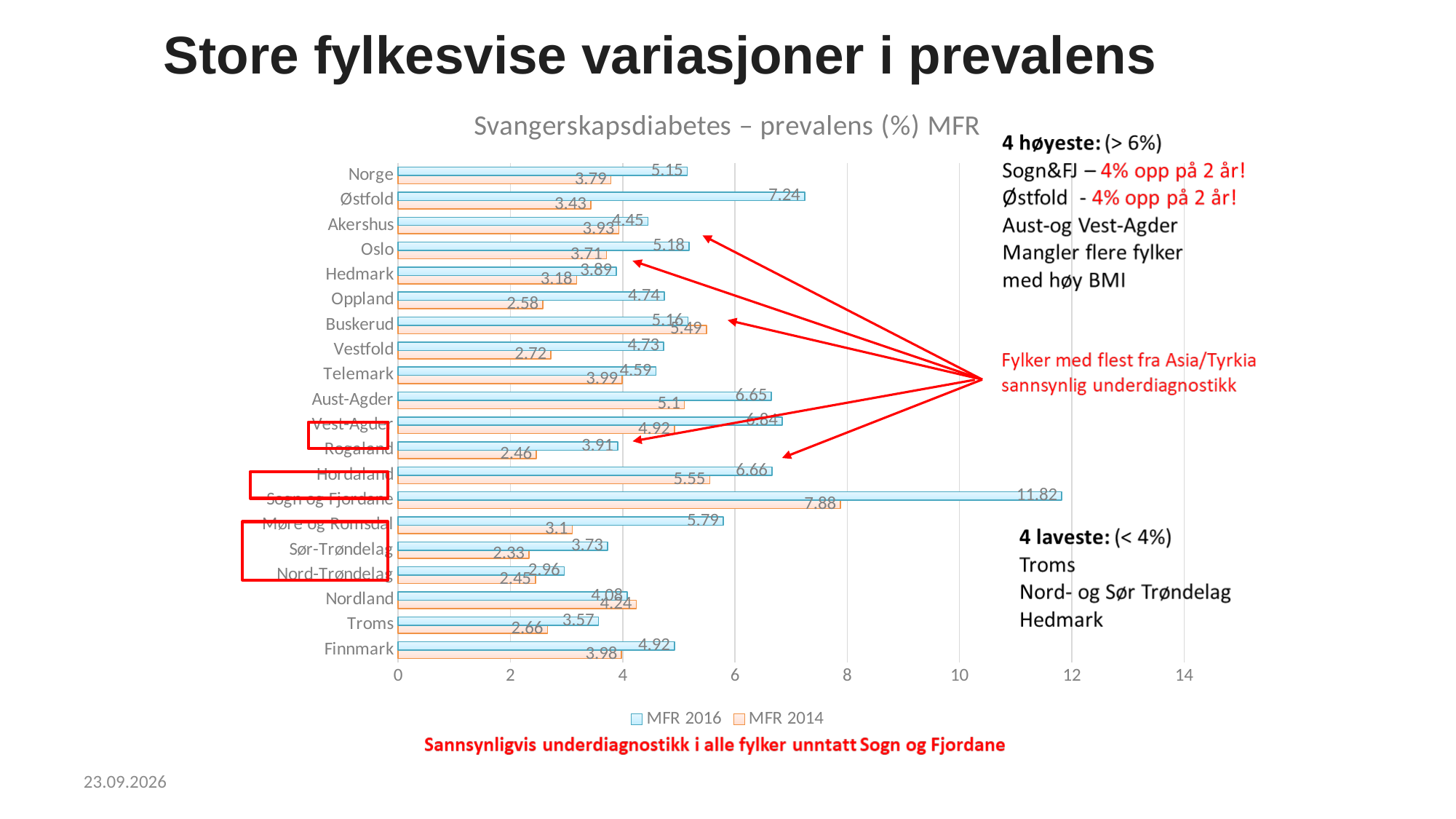
What is the title of the chart? Svangerskapsdiabetes – prevalens (%) MFR How many series does the legend list? 2 Which county has the lowest MFR 2016 value? Nord-Trøndelag Which is larger for Buskerud, the MFR 2016 value or the MFR 2014 value? MFR 2014 What is the difference between the MFR 2016 and MFR 2014 values for Sogn og Fjordane? 3.94 What is the MFR 2014 value for Oppland? 2.58 Which county has the lowest MFR 2014 value? Sør-Trøndelag How many categories are shown on the y axis of the chart? 20 What is the MFR 2016 value for Norge? 5.15 What type of chart is shown on the slide? Bar chart Which county has the highest MFR 2016 value? Sogn og Fjordane What is the MFR 2016 value for Østfold? 7.24